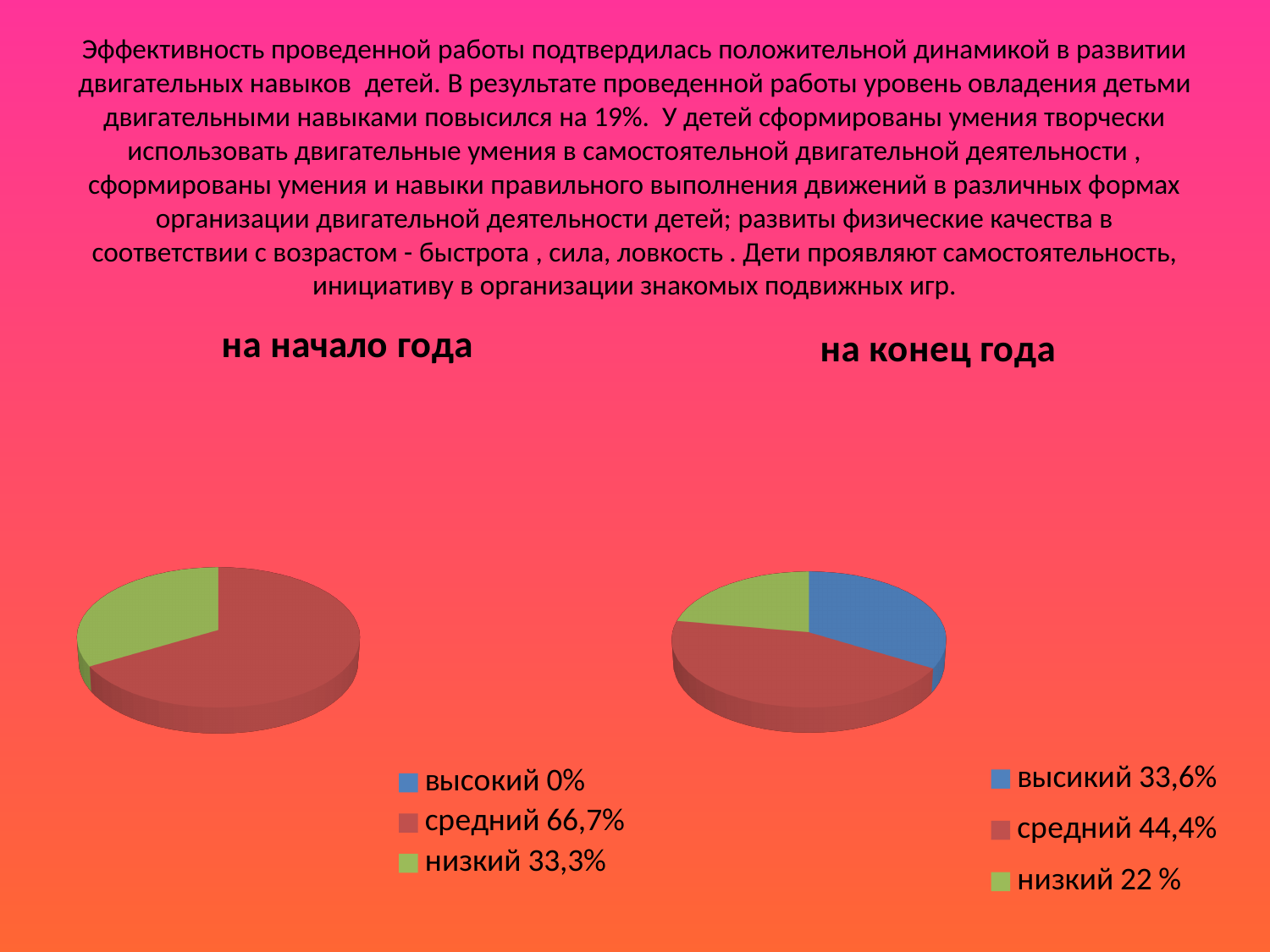
On the chart titled "на конец года", what share is shown for высикий? 33,6% On the chart titled "на конец года", which category has the smallest share? низкий On the chart titled "на начало года", what share is shown for низкий? 33,3% How many categories does the legend of the chart titled "на конец года" list? 3 On the chart titled "на конец года", what share is shown for низкий? 22 % On the chart titled "на конец года", which category has the largest share? средний On the chart titled "на начало года", what share is shown for средний? 66,7% What kind of chart is the chart titled "на начало года"? pie chart On the chart titled "на начало года", which category has the smallest share? высокий On the chart titled "на начало года", what colour represents средний? red On the chart titled "на конец года", which is larger, the share for высикий or the share for низкий? высикий On the chart titled "на начало года", what is the difference between the средний and низкий shares? 33,4%